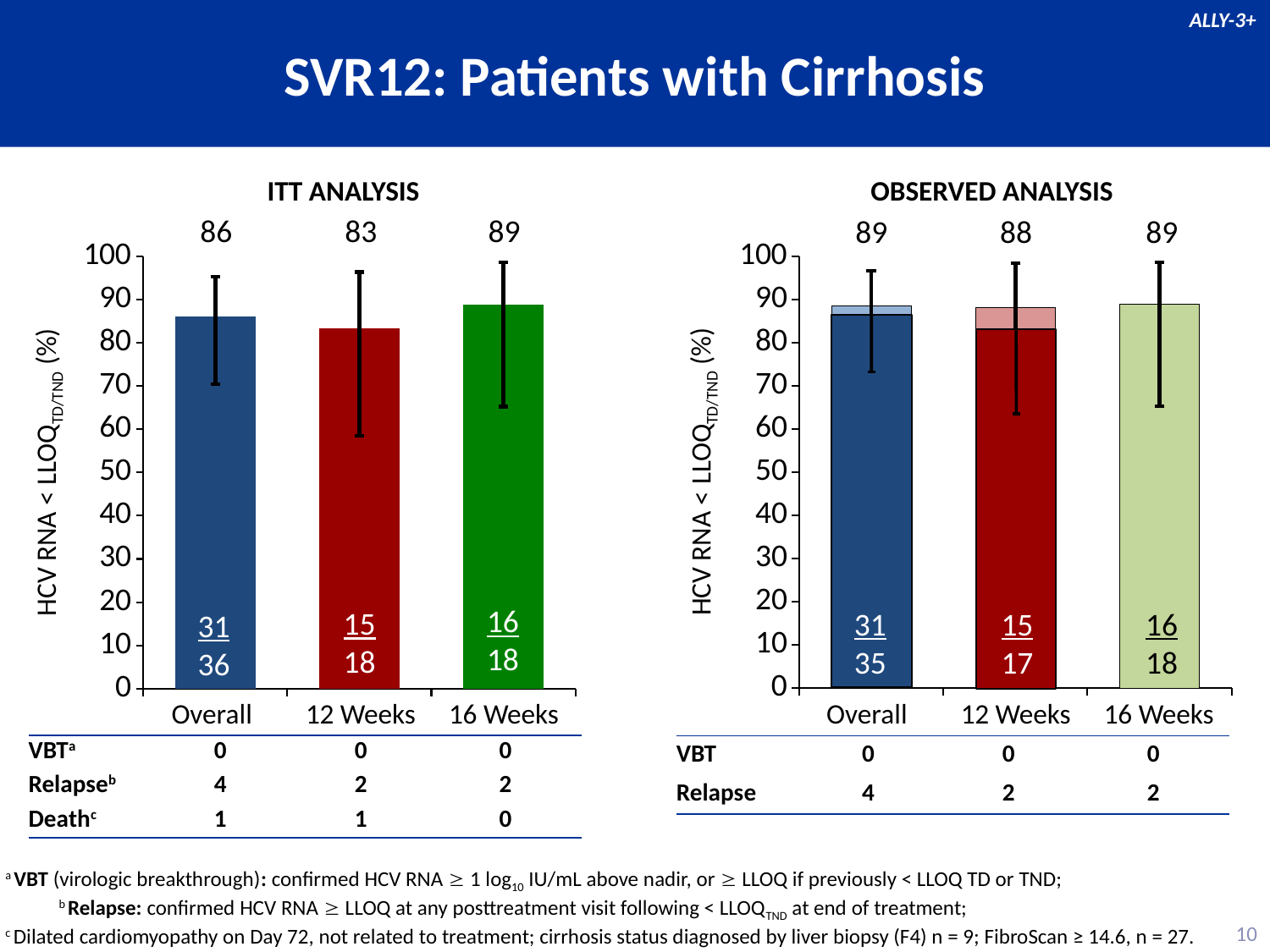
In the ITT Analysis chart, what is the difference between the 16 Weeks value and the 12 Weeks value? 6 In the Observed Analysis chart, what is the difference between the Overall value and the 12 Weeks value? 1 In the ITT Analysis chart, which is larger: the Overall value or the 12 Weeks value? Overall In the ITT Analysis chart, what is the value for the 12 Weeks group? 83 In the ITT Analysis chart, what is the SVR12 value for the Overall group? 86 What type of chart is the ITT Analysis chart? Bar chart In the ITT Analysis chart, which group has the highest SVR12 value? 16 Weeks In the ITT Analysis chart, which group has the lowest SVR12 value? 12 Weeks In the Observed Analysis chart, what is the value for the 16 Weeks group? 89 How many groups are shown on the x axis of the Observed Analysis chart? 3 In the Observed Analysis chart, what is the value for the 12 Weeks group? 88 In the ITT Analysis chart, what fraction is printed inside the Overall bar? 31/36